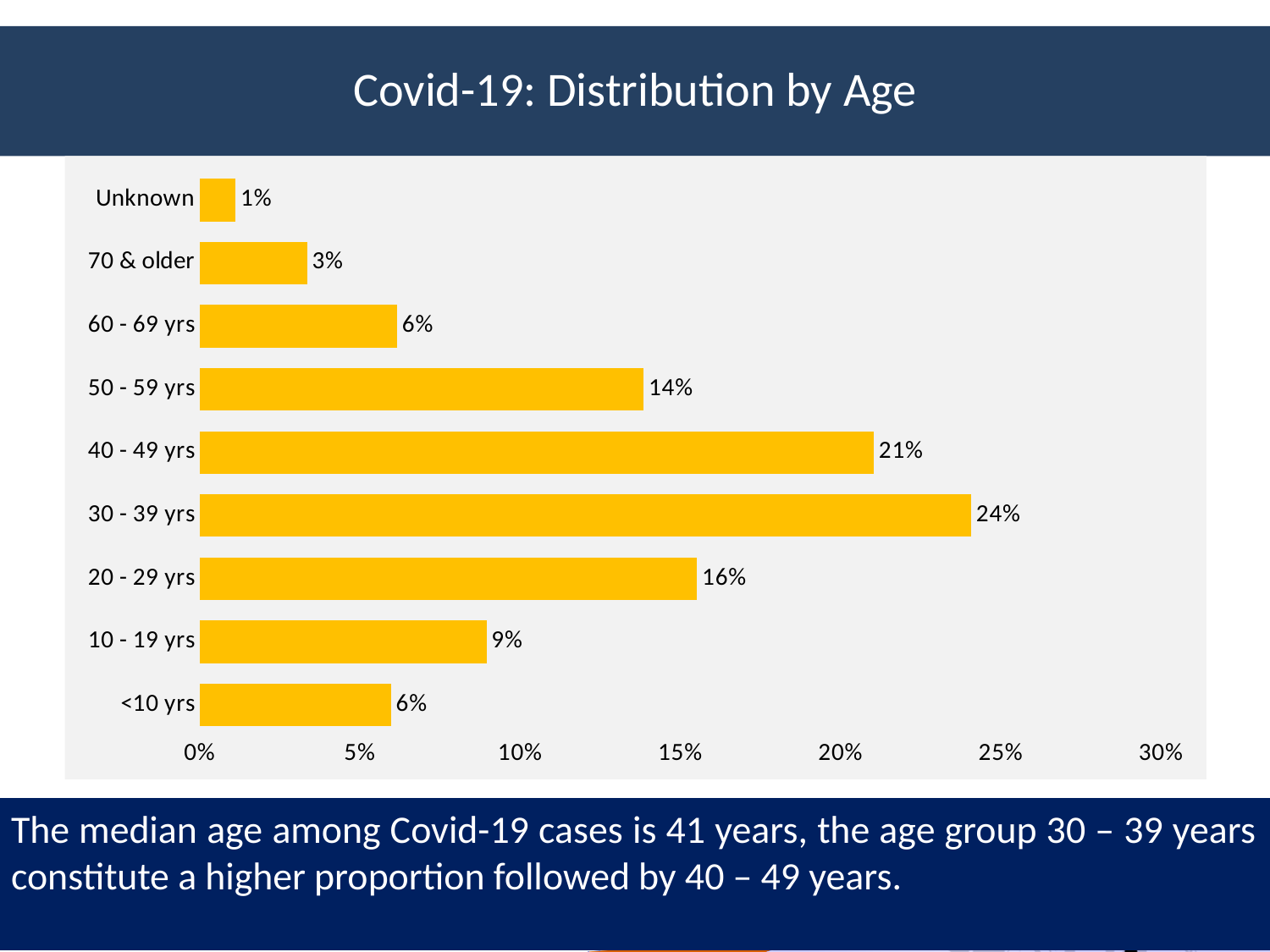
Which category has the lowest percentage? Unknown What is the value shown for the 50 - 59 yrs age group? 14% Which age group has the highest percentage of cases? 30 - 39 yrs What percentage is shown for the Unknown age category? 1% Is the value for 40 - 49 yrs greater or less than 20%? greater What type of chart is shown on the slide? Bar chart What is the difference between the 20 - 29 yrs and 10 - 19 yrs values? 7% What percentage of Covid-19 cases are in the 30 - 39 yrs age group? 24% What is the title of the slide containing the chart? Covid-19: Distribution by Age Which has a larger share of cases, 20 - 29 yrs or 50 - 59 yrs? 20 - 29 yrs What is the difference in percentage points between the 30 - 39 yrs and 40 - 49 yrs groups? 3% How many age categories are shown in the chart? 9